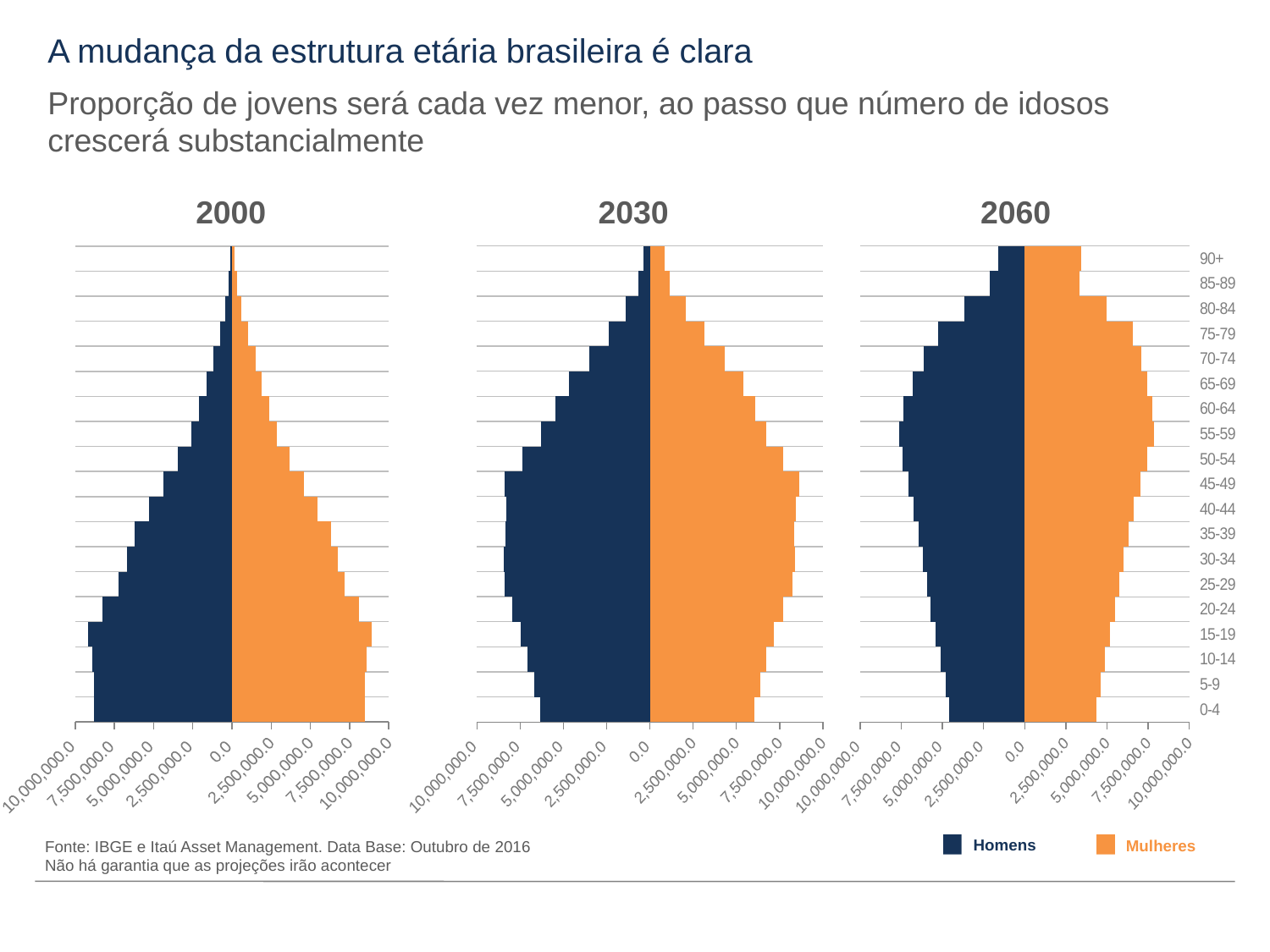
What are the two series named in the legend? Homens and Mulheres In the 2000 chart, which age group has the smallest Homens bar? 90+ In the 2030 chart, is the Homens value for the 90+ age group greater or less than 2,500,000.0? less How many age groups are listed on the vertical axis of the charts? 19 Which colour represents Mulheres in the charts? orange In the 2060 chart, which is larger for the 90+ age group, Homens or Mulheres? Mulheres What kind of chart is used for the 2000, 2030 and 2060 panels? bar chart In the 2060 chart, is the Homens value for the 0-4 age group greater or less than 5,000,000.0? less How many series does the legend list? 2 Is the Homens bar for the 0-4 age group larger in the 2000 chart or in the 2060 chart? 2000 In the 2060 chart, is the Mulheres value for the 90+ age group greater or less than 2,500,000.0? greater